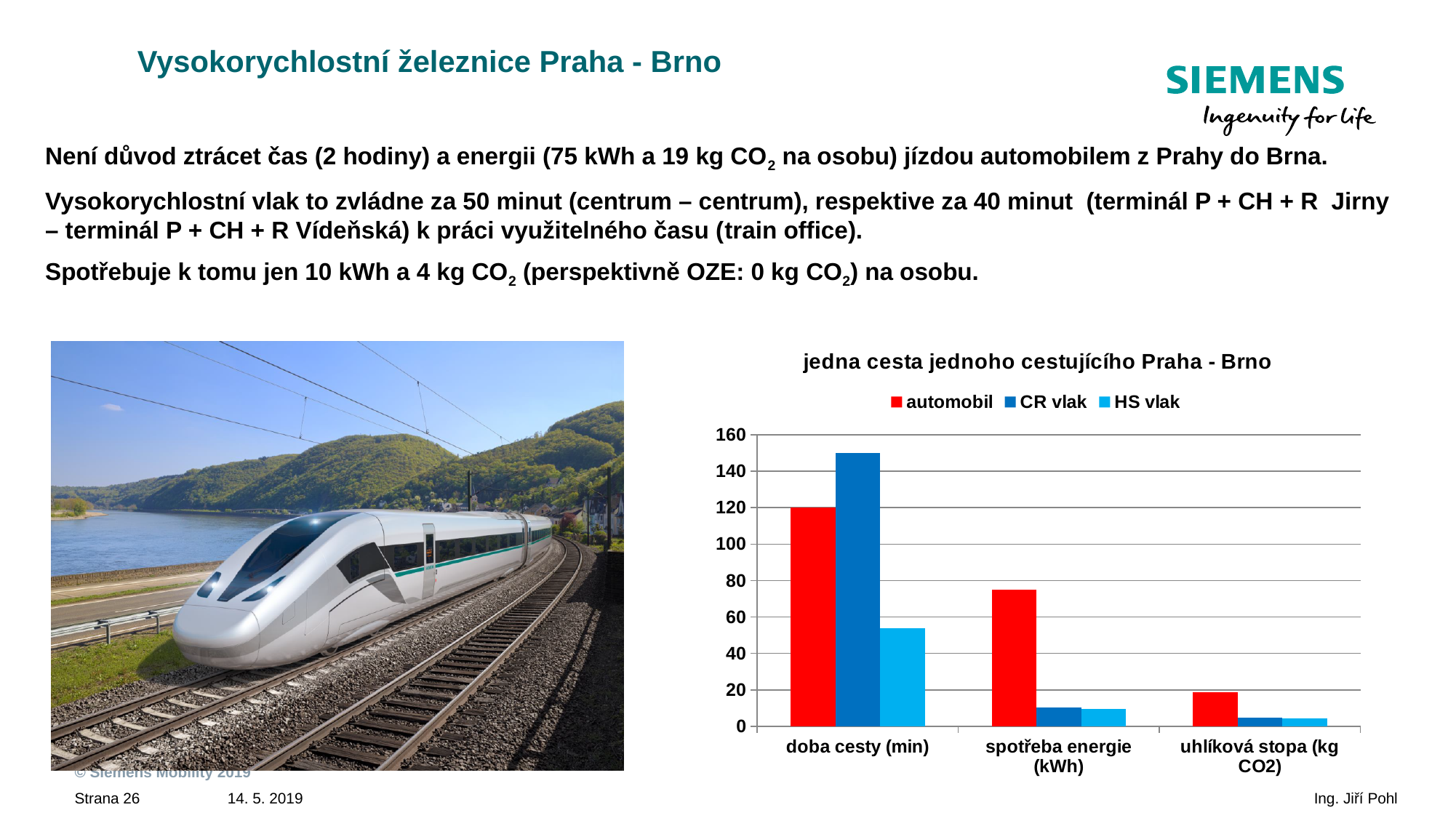
What kind of chart is shown on the slide? bar chart Is the value for CR vlak in spotřeba energie (kWh) greater or less than 20? less Is the value for automobil in spotřeba energie (kWh) greater or less than 60? greater Which series is shown in red in the chart? automobil Which series has the lowest value for doba cesty (min)? HS vlak How many categories are shown on the x axis of the chart? 3 What is the title of the chart? jedna cesta jednoho cestujícího Praha - Brno How many series does the chart legend list? 3 Is the value for HS vlak in doba cesty (min) greater or less than 40? greater Which series has the highest value for doba cesty (min)? CR vlak Which is larger for uhlíková stopa (kg CO2): automobil or HS vlak? automobil